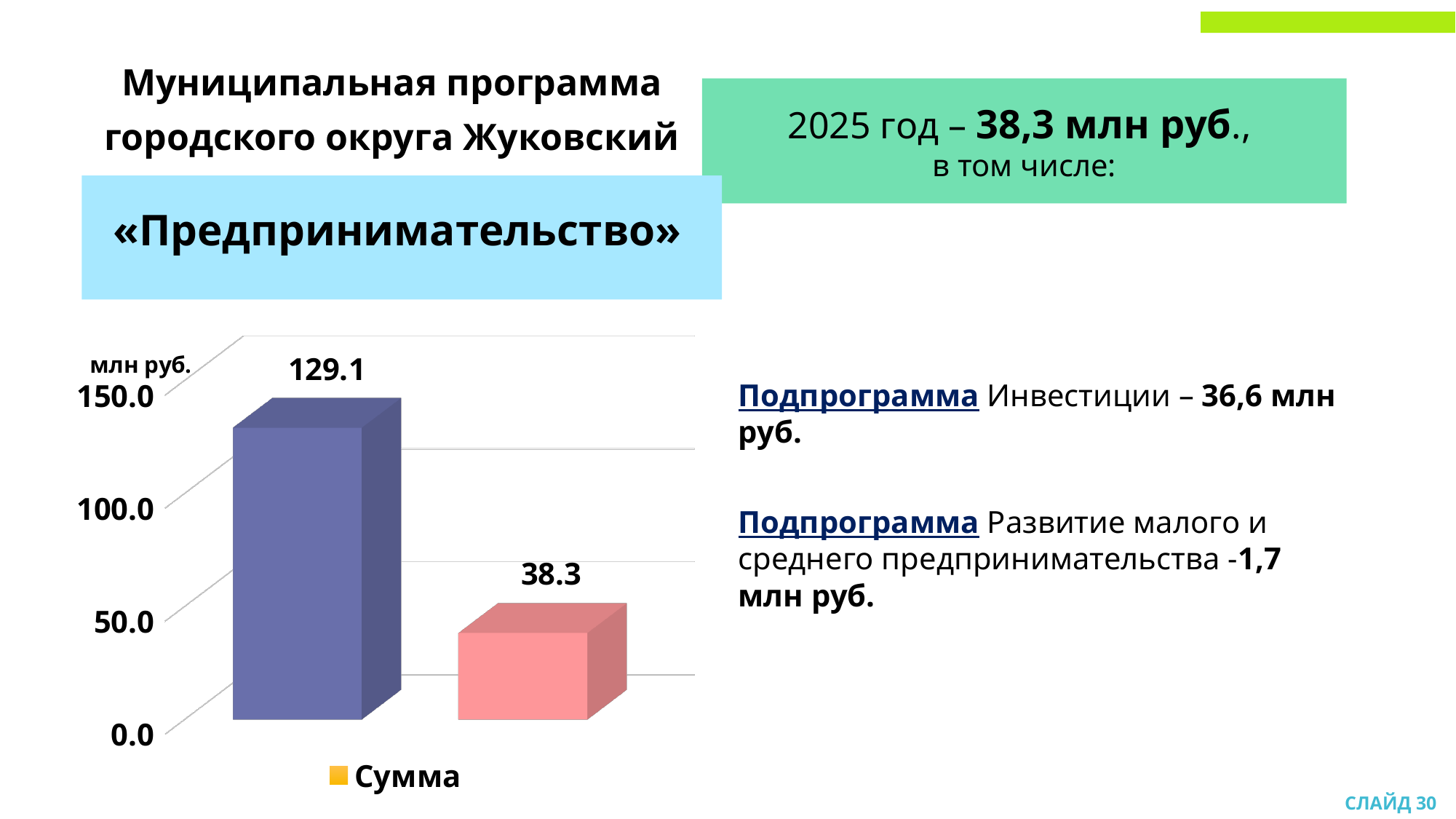
Is the value of the right pink bar greater or less than 50.0? less What is the value of the left (blue) bar in the chart? 129.1 How many bars are plotted in the chart? 2 Which bar has the highest value, the left blue one or the right pink one? the left blue bar What is the name of the series shown in the chart legend? Сумма Is the value of the left blue bar greater or less than 100.0? greater What kind of chart is shown on the slide? bar chart What is the difference between the values of the left bar and the right bar? 90.8 Which bar has the lowest value, the left blue one or the right pink one? the right pink bar What is the value of the right (pink) bar in the chart? 38.3 Do the values rise or fall from the left bar to the right bar? fall How many series does the chart legend list? 1